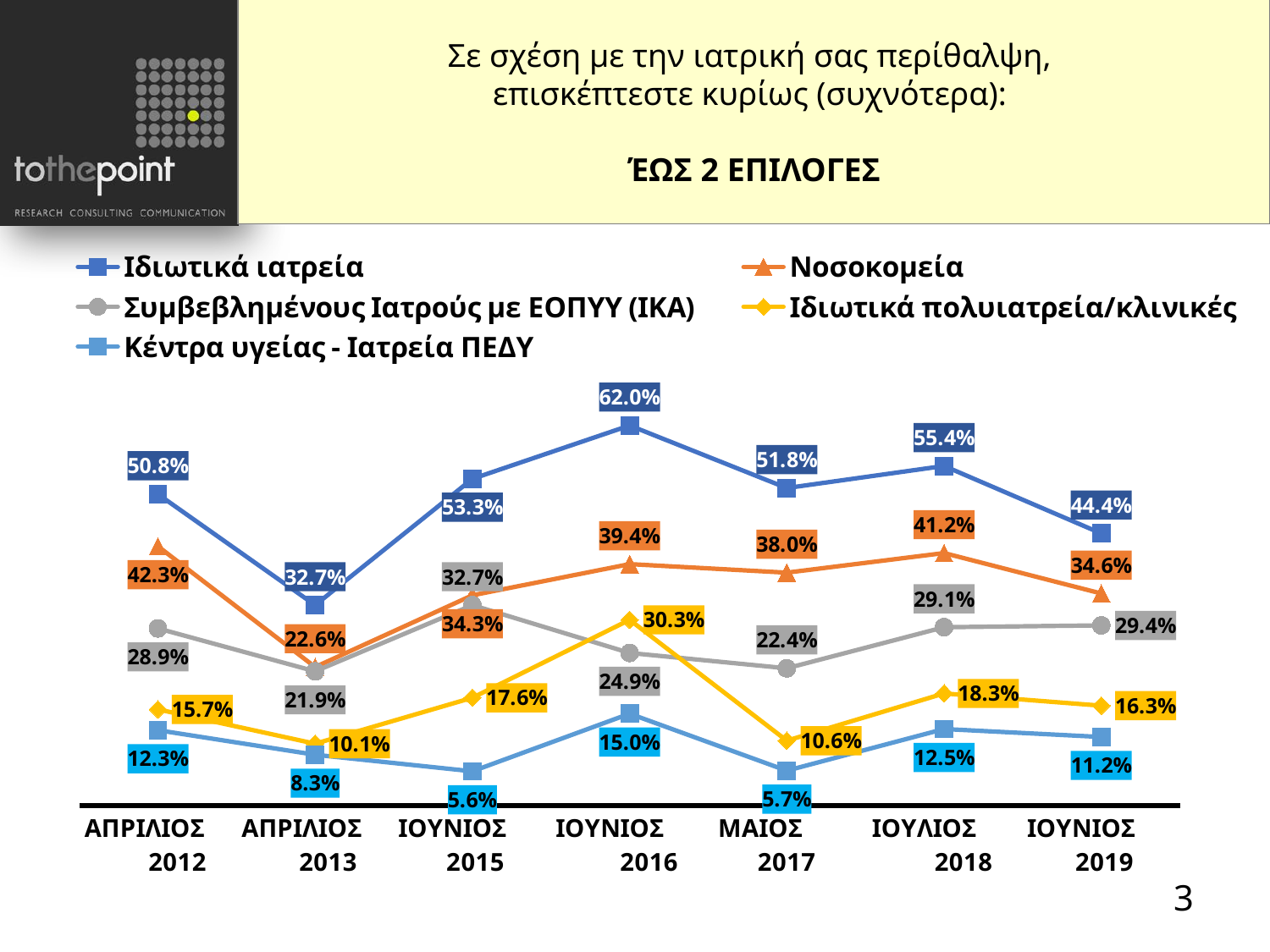
How many series does the legend list? 5 How many time points are plotted along the x axis? 7 What is the difference between the Ιδιωτικά ιατρεία values in ΙΟΥΛΙΟΣ 2018 and ΙΟΥΝΙΟΣ 2019? 11.0% What is the value for Κέντρα υγείας - Ιατρεία ΠΕΔΥ in ΜΑΙΟΣ 2017? 5.7% In which time point does Ιδιωτικά πολυιατρεία/κλινικές reach its highest value? ΙΟΥΝΙΟΣ 2016 What is the value for Ιδιωτικά ιατρεία in ΙΟΥΝΙΟΣ 2016? 62.0% Does the value for Νοσοκομεία rise or fall from ΜΑΙΟΣ 2017 to ΙΟΥΛΙΟΣ 2018? rise What is the value for Νοσοκομεία in ΑΠΡΙΛΙΟΣ 2013? 22.6% In which time point does Ιδιωτικά ιατρεία have its lowest value? ΑΠΡΙΛΙΟΣ 2013 Which is larger in ΙΟΥΝΙΟΣ 2019: Συμβεβλημένους Ιατρούς με ΕΟΠΥΥ (ΙΚΑ) or Νοσοκομεία? Νοσοκομεία Which series is shown with a yellow line and diamond markers? Ιδιωτικά πολυιατρεία/κλινικές What kind of chart is shown on the slide? line chart